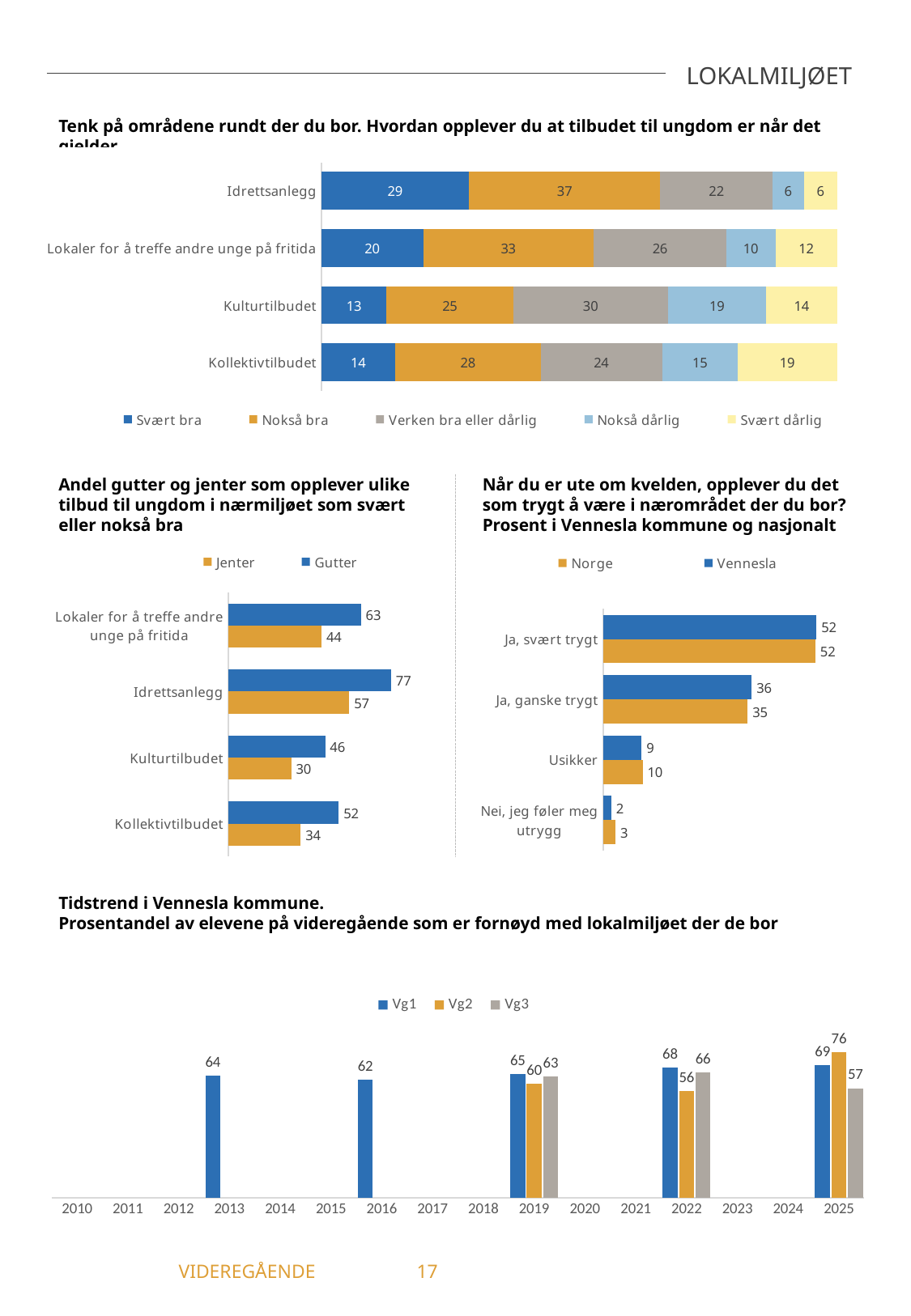
In the chart 'Andel gutter og jenter som opplever ulike tilbud til ungdom i nærmiljøet som svært eller nokså bra', what is the difference between Gutter and Jenter for Idrettsanlegg? 20 In the top stacked bar chart about tilbudet til ungdom, what is the value for 'Svært bra' for Idrettsanlegg? 29 In the top stacked bar chart about tilbudet til ungdom, which category has the highest 'Svært dårlig' value? Kollektivtilbudet In the top stacked bar chart about tilbudet til ungdom, what is the total of the Kollektivtilbudet bar? 100 In the chart 'Når du er ute om kvelden, opplever du det som trygt å være i nærområdet der du bor?', what is the value for Vennesla for 'Usikker'? 9 In the chart 'Tidstrend i Vennesla kommune', how many series does the legend list? 3 In the chart 'Når du er ute om kvelden, opplever du det som trygt å være i nærområdet der du bor?', which is larger for 'Ja, ganske trygt': Norge or Vennesla? Vennesla What kind of chart is the 'Tidstrend i Vennesla kommune' chart? Bar chart In the chart 'Tidstrend i Vennesla kommune', what is the value for Vg2 in 2025? 76 In the chart 'Andel gutter og jenter som opplever ulike tilbud til ungdom i nærmiljøet som svært eller nokså bra', what is the value for Jenter for Kulturtilbudet? 30 In the top stacked bar chart about tilbudet til ungdom, how many series does the legend list? 5 In the chart 'Andel gutter og jenter som opplever ulike tilbud til ungdom i nærmiljøet som svært eller nokså bra', which category has the lowest value for Gutter? Kulturtilbudet